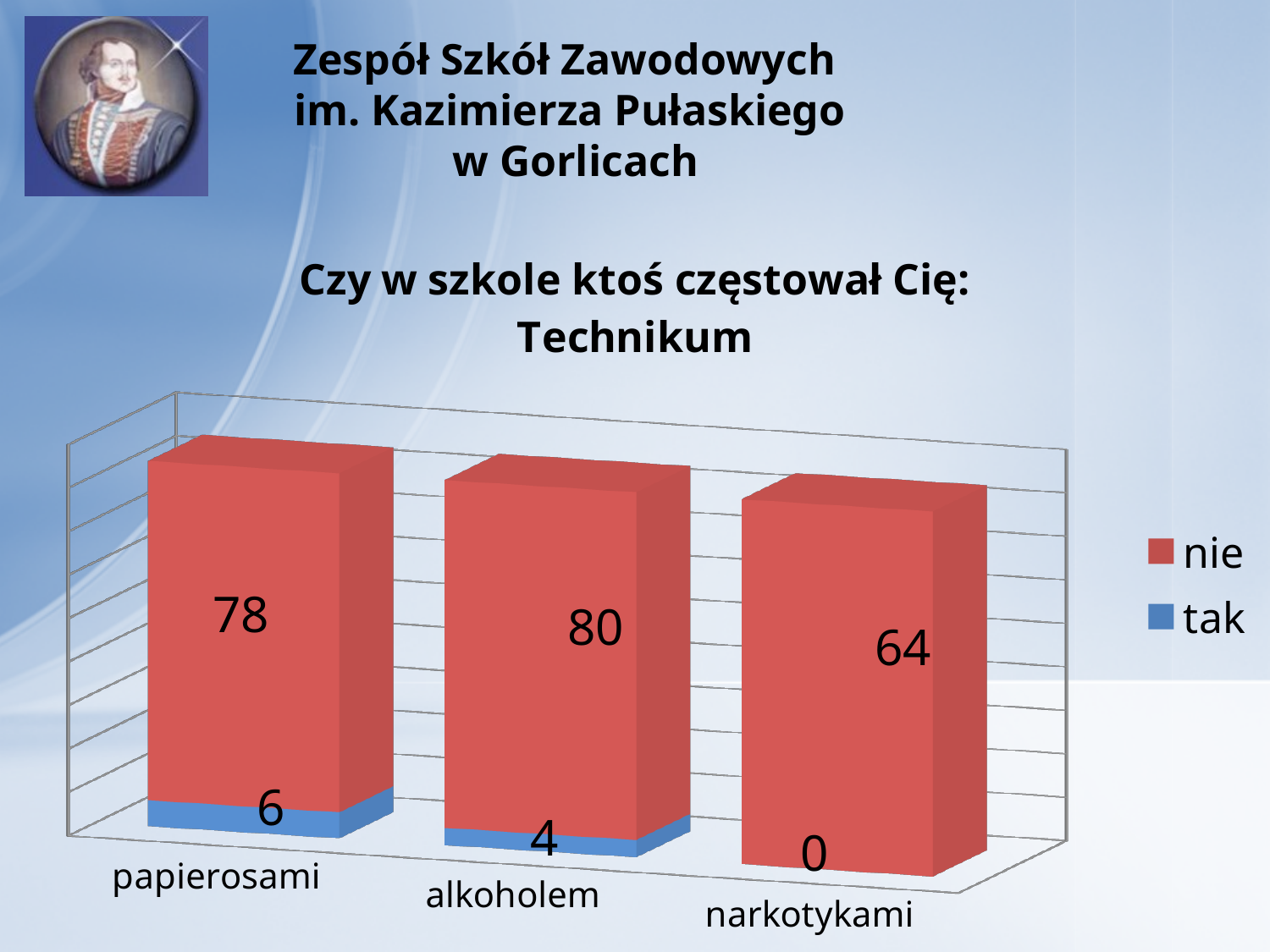
What is the value for "nie" for narkotykami? 64 What kind of chart is shown on the slide? stacked bar chart What is the total of the stacked bar for papierosami? 84 What is the value for "tak" for alkoholem? 4 How many series does the legend list? 2 What is the difference between the "nie" values for alkoholem and narkotykami? 16 What is the value for "tak" for narkotykami? 0 Which is larger: the "tak" value for papierosami or for alkoholem? papierosami Which category has the highest "nie" value? alkoholem Which category has the lowest "tak" value? narkotykami How many categories are shown on the x axis? 3 What is the value for "nie" for papierosami? 78